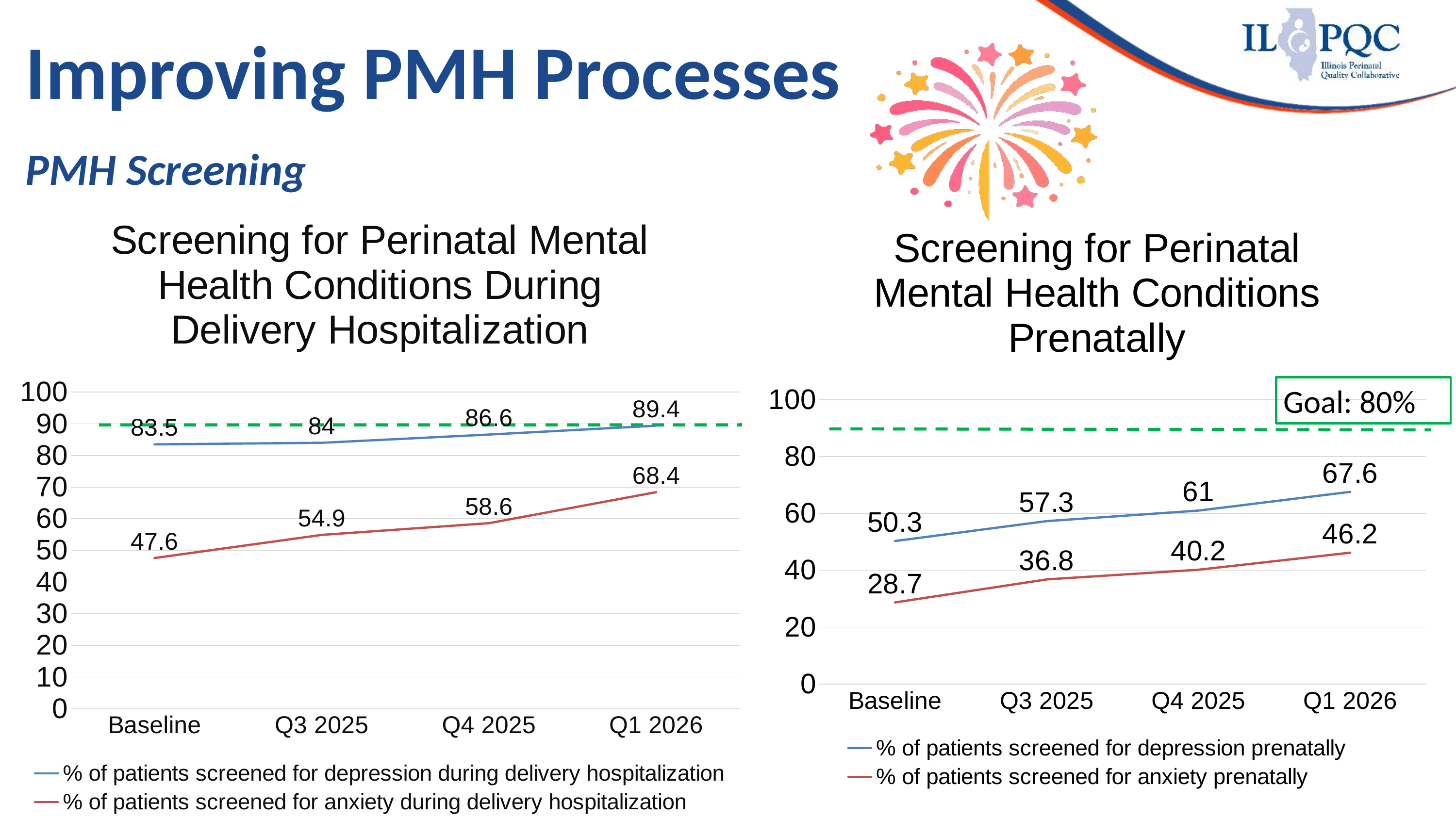
In the left chart (Screening During Delivery Hospitalization), what is the value for anxiety screening at Baseline? 47.6 What type of chart is the right chart (Screening Prenatally)? line chart In the right chart (Screening Prenatally), at which time point is anxiety screening lowest? Baseline In the right chart (Screening Prenatally), what is the value for depression screening at Q4 2025? 61 In the left chart (Screening During Delivery Hospitalization), what is the difference between the anxiety screening values at Q1 2026 and Baseline? 20.8 How many series does the legend of the right chart (Screening Prenatally) list? 2 In the right chart (Screening Prenatally), what is the difference between depression and anxiety screening at Q1 2026? 21.4 In the left chart (Screening During Delivery Hospitalization), at which time point is depression screening highest? Q1 2026 In the right chart (Screening Prenatally), does depression screening rise or fall from Baseline to Q1 2026? rise How many time points are shown on the x axis of the left chart (Screening During Delivery Hospitalization)? 4 In the right chart (Screening Prenatally), what is the value for anxiety screening at Q3 2025? 36.8 In the left chart (Screening During Delivery Hospitalization), what is the value for depression screening at Q1 2026? 89.4